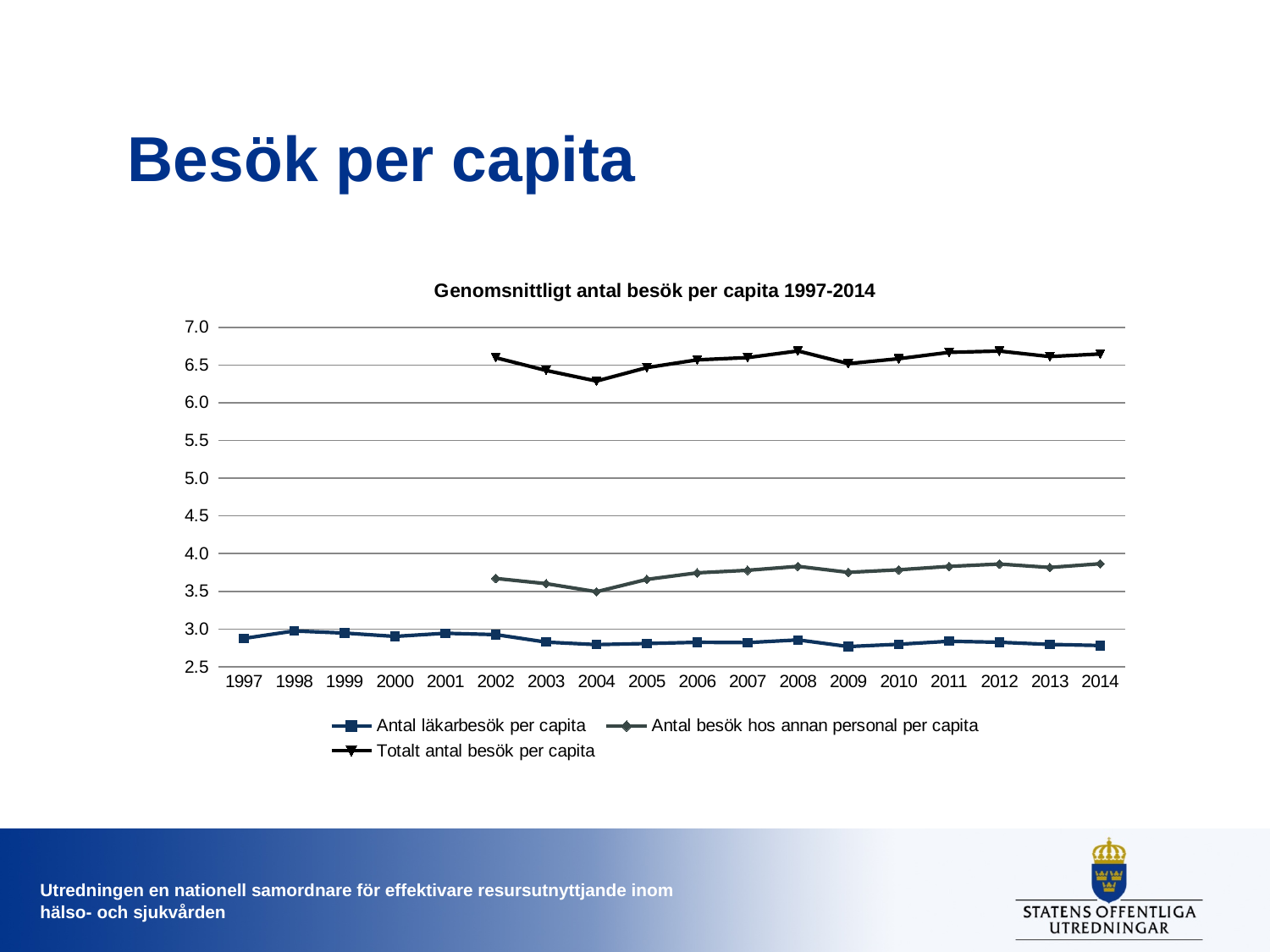
In which year is Antal besök hos annan personal per capita lowest? 2004 Is the value for Antal läkarbesök per capita in 2009 greater or less than 3.0? less In 2010, which is larger: Antal besök hos annan personal per capita or Antal läkarbesök per capita? Antal besök hos annan personal per capita How many series does the legend list? 3 Is the value for Totalt antal besök per capita in 2004 greater or less than 6.5? less Does Antal läkarbesök per capita rise or fall overall from 1997 to 2014? fall How many years are shown on the x axis? 18 In which year is Totalt antal besök per capita lowest? 2004 What kind of chart is shown on the slide? Line chart Is the value for Totalt antal besök per capita in 2012 greater or less than 6.5? greater What is the title of the chart? Genomsnittligt antal besök per capita 1997-2014